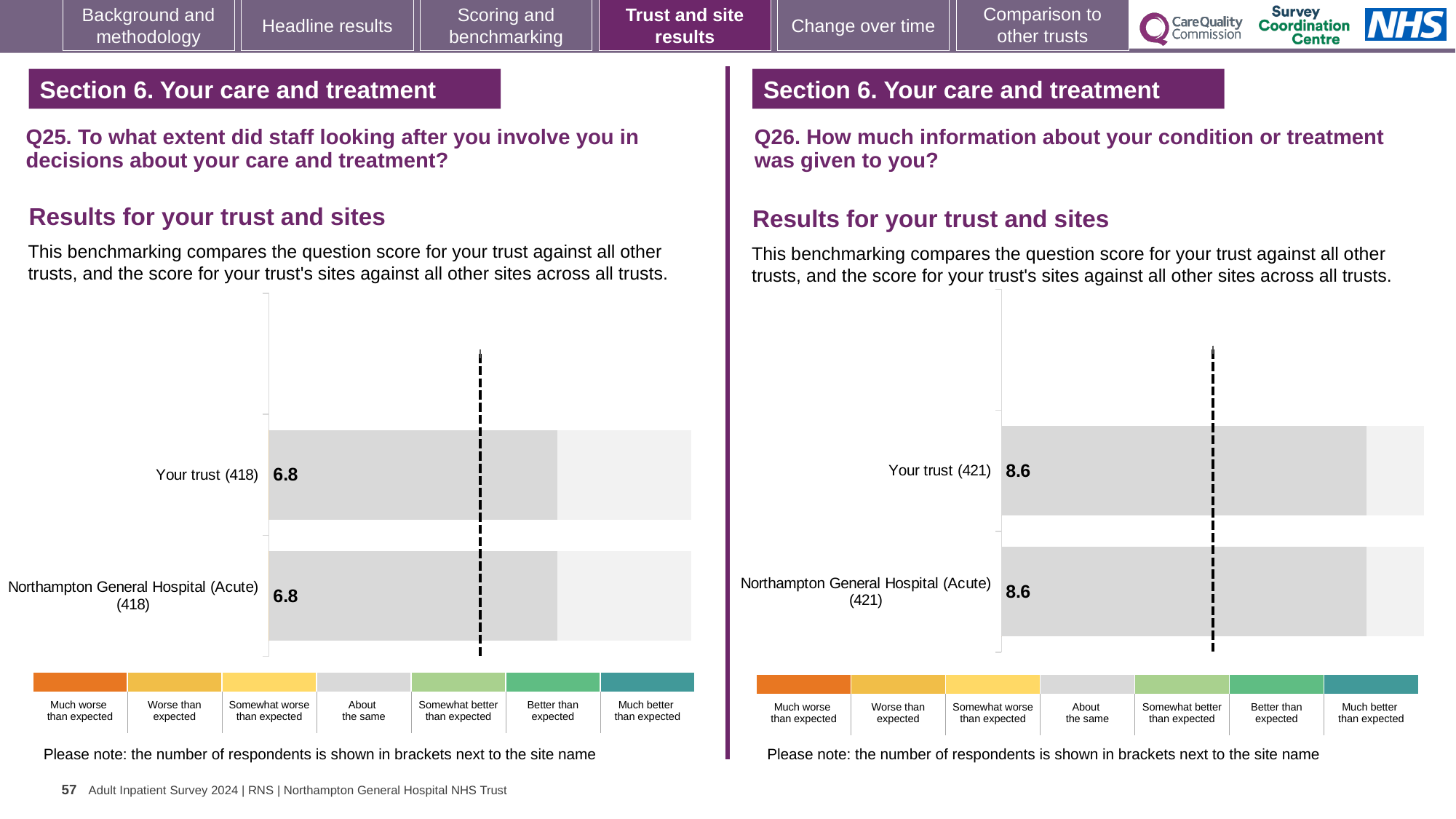
On the Q26 chart (right), what is the difference between the score for Your trust and the score for Northampton General Hospital (Acute)? 0 How many categories does the colour key below the Q26 chart (right) list? 7 How many bars are plotted on the Q25 chart (left)? 2 On the Q26 chart (right), what is the score for Northampton General Hospital (Acute)? 8.6 On the Q25 chart (left), what is the score for Northampton General Hospital (Acute)? 6.8 How many bars are plotted on the Q26 chart (right)? 2 On the Q25 chart (left), how many respondents are shown in brackets for Your trust? 418 What kind of chart is used for the Q25 results (left)? Bar chart On the Q26 chart (right), how many respondents are shown in brackets for Northampton General Hospital (Acute)? 421 On the Q26 chart (right), what is the score for Your trust? 8.6 On the Q25 chart (left), what is the score for Your trust? 6.8 On the Q25 chart (left), what is the difference between the score for Your trust and the score for Northampton General Hospital (Acute)? 0